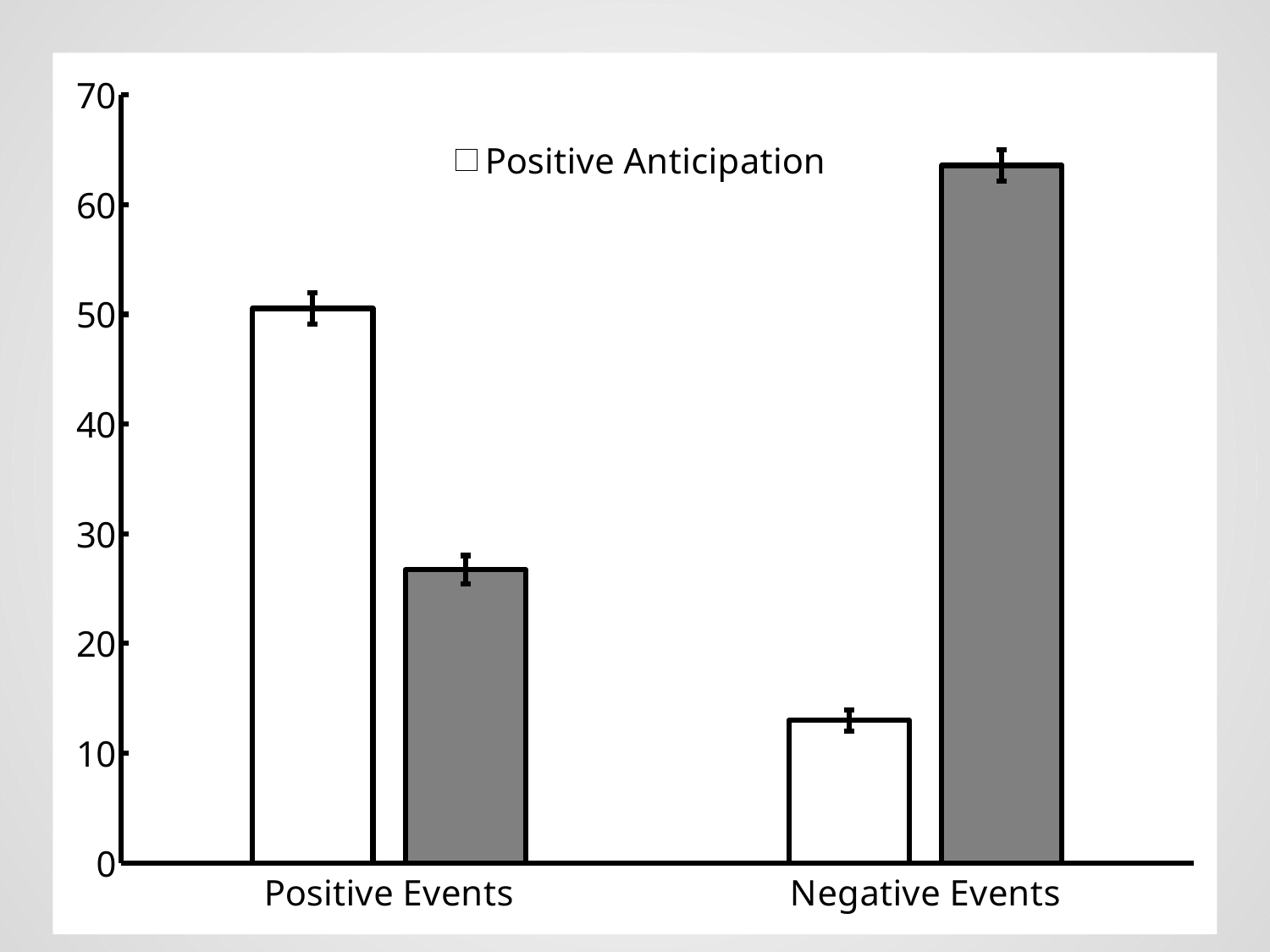
For Negative Events, which is larger: the white Positive Anticipation bar or the gray bar? the gray bar How many series does the legend list? 1 Is the Positive Anticipation value for Negative Events greater or less than 20? less What kind of chart is shown on the slide? bar chart What is the highest value shown on the y axis? 70 What is the series name shown in the legend? Positive Anticipation How many categories are shown on the x axis? 2 Which category has the lower Positive Anticipation value? Negative Events Is the gray bar for Negative Events greater or less than 60? greater Which category has the higher Positive Anticipation value? Positive Events Is the Positive Anticipation value for Positive Events greater or less than 40? greater